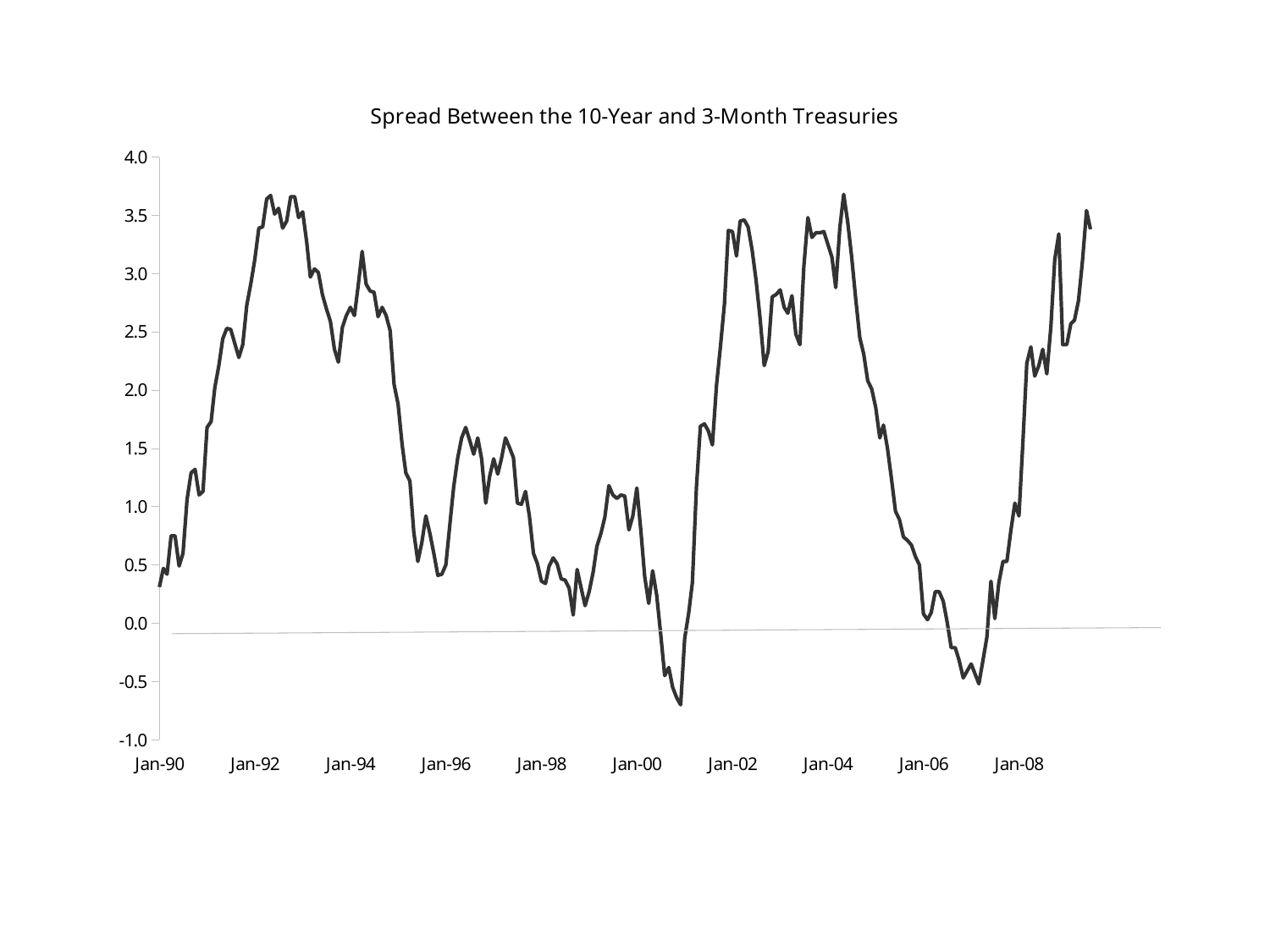
Which is larger, the value at Jan-92 or the value at Jan-96? Jan-92 Is the value at Jan-90 greater or less than 1.0? less Does the spread rise or fall between Jan-04 and Jan-06? fall How many date labels are shown on the x axis? 10 Is the value at Jan-06 greater or less than 1.0? less Is the value at Jan-92 greater or less than 3.0? greater What is the title of the chart? Spread Between the 10-Year and 3-Month Treasuries Does the spread rise or fall between Jan-00 and Jan-02? rise What kind of chart is shown on the slide? line chart